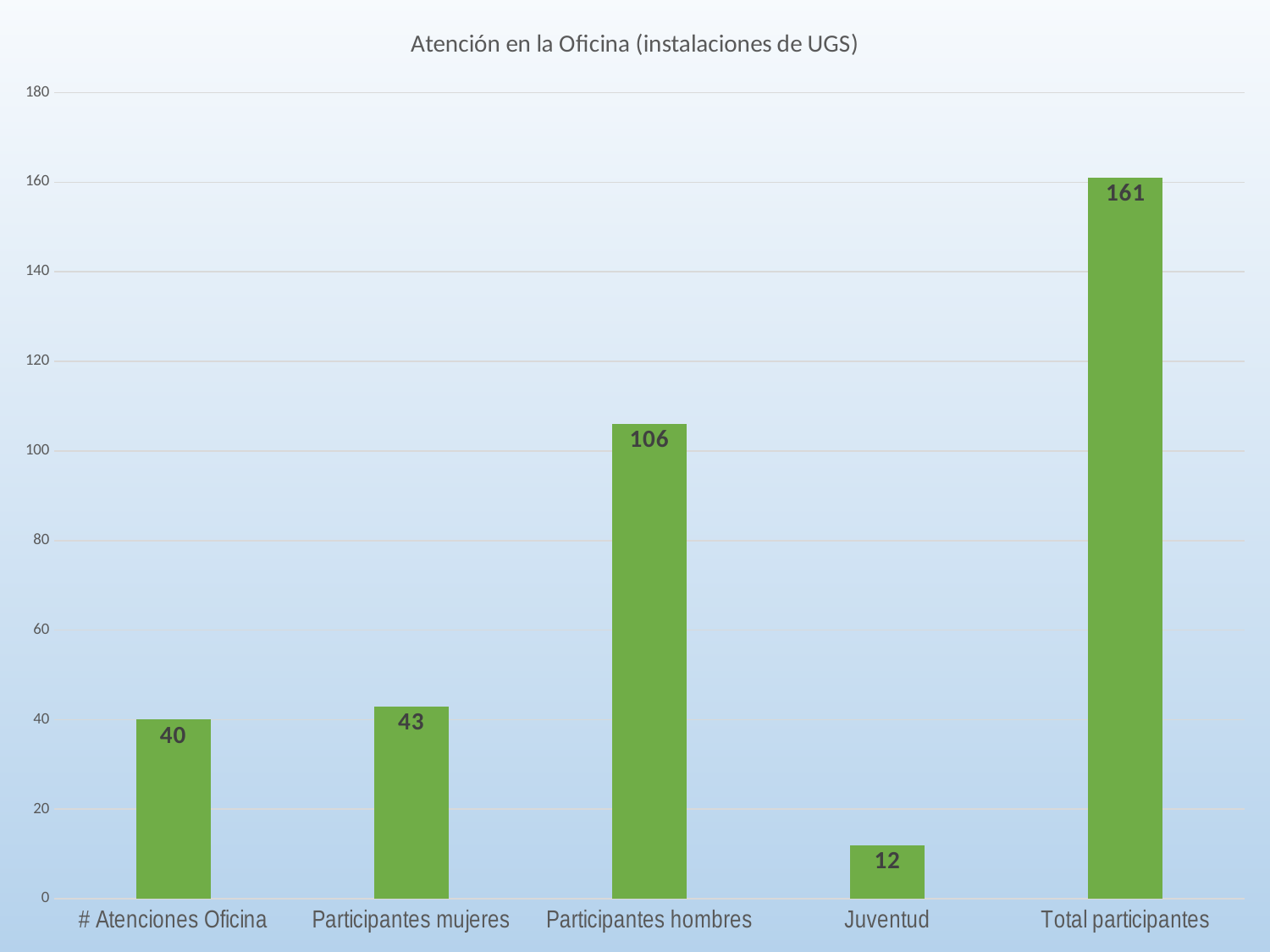
Is the value for Total participantes greater or less than 140? greater What is the value for Juventud? 12 Which is larger, Participantes hombres or Participantes mujeres? Participantes hombres What is the value for Participantes hombres? 106 Which category has the lowest value? Juventud Which category has the highest value? Total participantes What is the value for # Atenciones Oficina? 40 What is the difference between Participantes mujeres and # Atenciones Oficina? 3 What is the value for Participantes mujeres? 43 What is the difference between Total participantes and Participantes hombres? 55 What kind of chart is this? Bar chart How many categories are shown on the x axis? 5